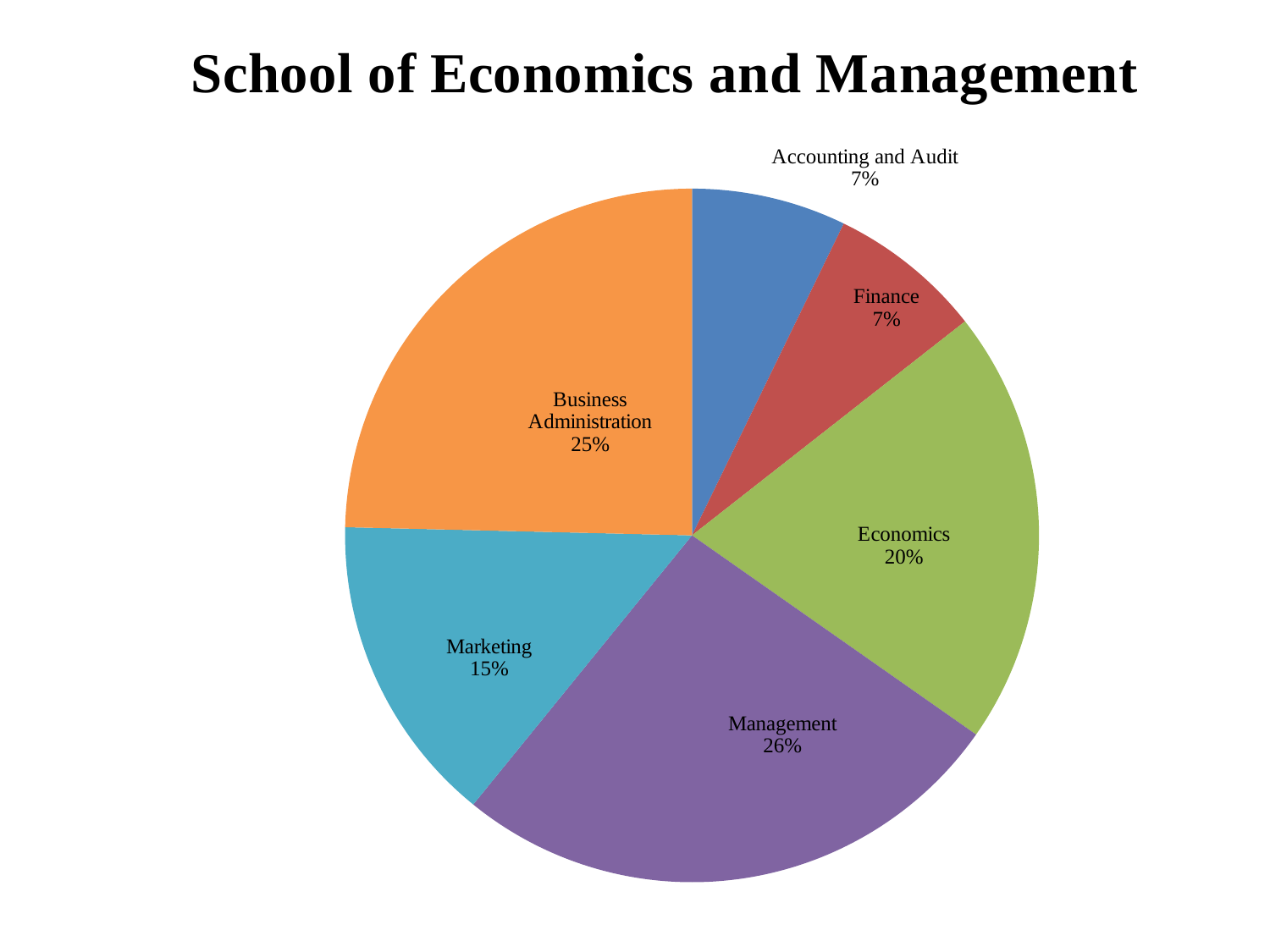
What share of the pie does Business Administration hold? 25% Which is larger, the Economics share or the Marketing share? Economics Which category has the largest slice of the pie? Management What share of the pie does Management hold? 26% What is the value shown for Economics? 20% What is the value shown for Accounting and Audit? 7% What is the value shown for Marketing? 15% What is the title of the slide? School of Economics and Management What is the value shown for Finance? 7% What type of chart is shown on the slide? pie chart What is the difference between the Management and Marketing shares? 11% How many slices does the pie chart have? 6